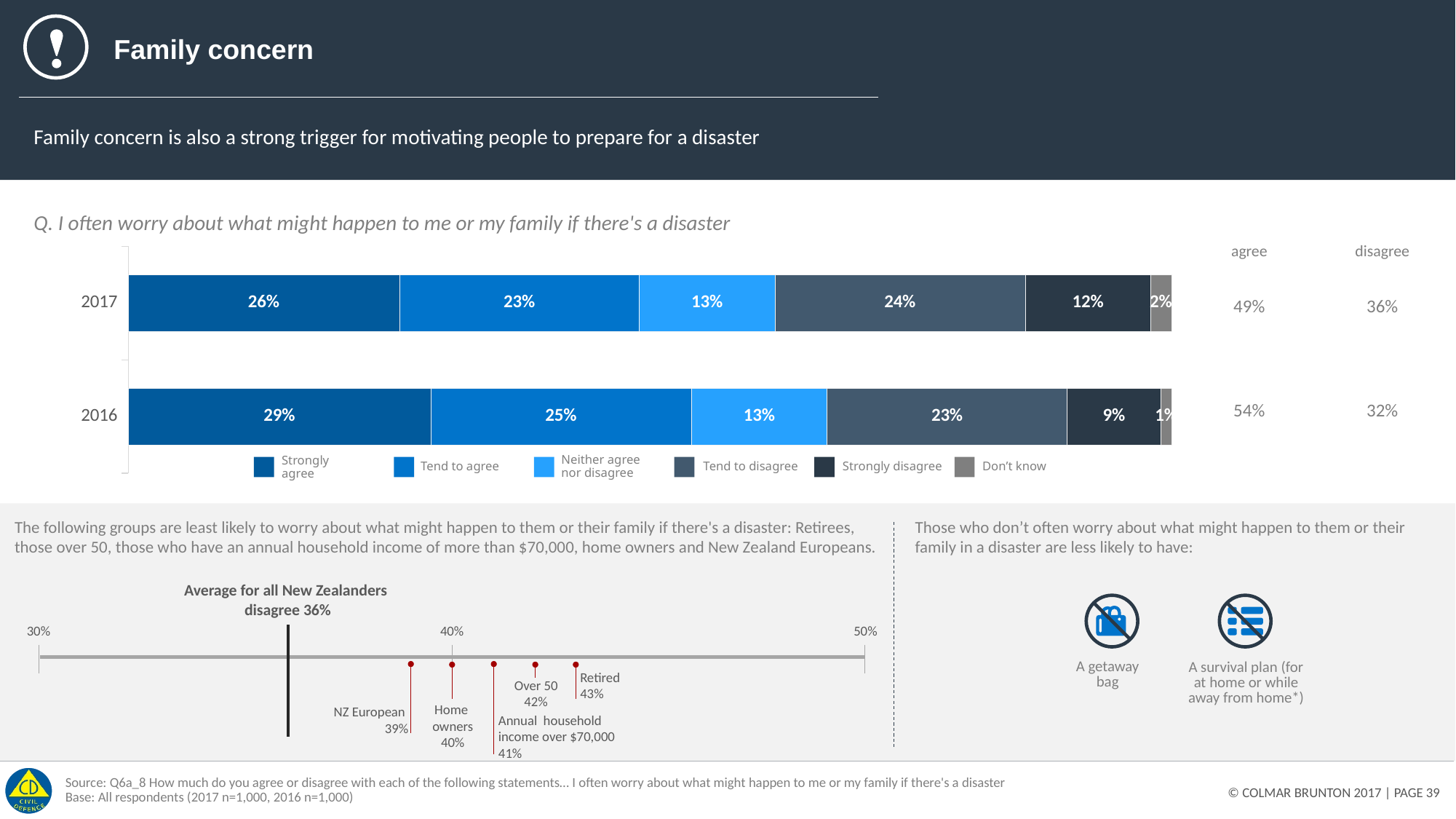
How many groups are plotted on the bottom-left number line chart? 5 In the stacked bar chart, what percentage of respondents in 2016 said they tend to disagree? 23% In the bottom-left number line chart, what is the disagree percentage for Retired? 43% In the stacked bar chart, what percentage of respondents in 2017 said they strongly agree? 26% In the bottom-left number line chart, which group has the highest disagree percentage? Retired In the stacked bar chart, which year has the larger 'Strongly disagree' value, 2017 or 2016? 2017 In the stacked bar chart, by how many percentage points did 'Strongly agree' change from 2016 to 2017? 3 percentage points In the bottom-left number line chart, which group has the lowest disagree percentage? NZ European In the stacked bar chart, what is the 'Don't know' value for 2017? 2% What kind of chart is the chart showing the 2017 and 2016 results? Stacked bar chart How many years (categories) are shown in the stacked bar chart? 2 How many series does the legend of the stacked bar chart list? 6